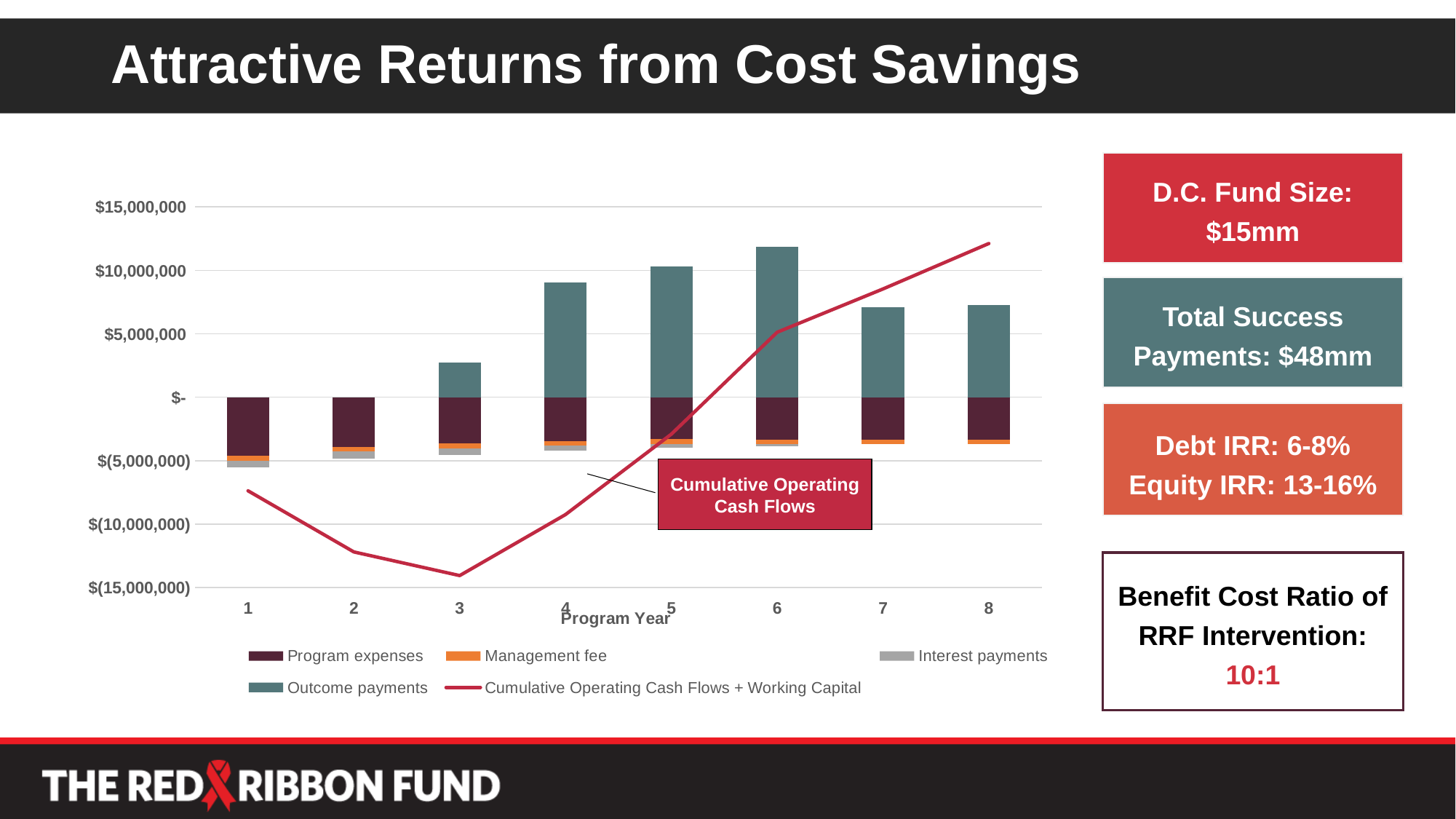
How many series does the chart's legend list? 5 In which program year does the Cumulative Operating Cash Flows + Working Capital line reach its lowest point? 3 What kind of chart is shown on the slide? A stacked bar chart combined with a line chart Is the value for Outcome payments in program year 6 greater or less than $10,000,000? greater How many program years are shown on the x axis of the chart? 8 From program year 3 to program year 8, does the Cumulative Operating Cash Flows + Working Capital line rise or fall? It rises What is the title of the chart's x axis? Program Year Is the value of the Cumulative Operating Cash Flows + Working Capital line in program year 8 greater or less than $10,000,000? greater Which program year has larger Outcome payments, year 5 or year 7? Year 5 Is the value of the Cumulative Operating Cash Flows + Working Capital line in program year 2 greater or less than $(10,000,000)? less In which program year are the Outcome payments highest? 6